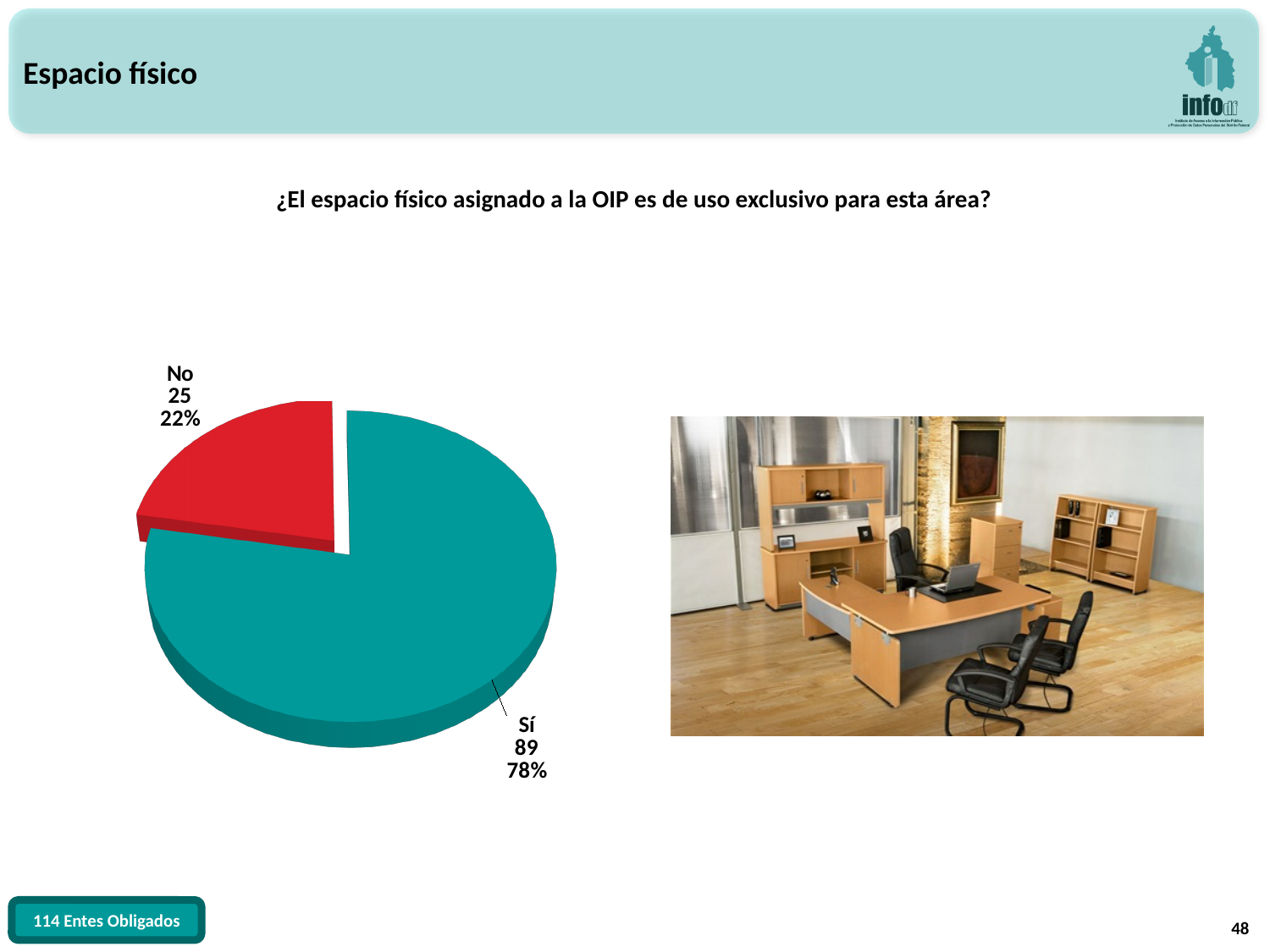
Which slice is the smallest? No What is the count for the "Sí" slice? 89 What is the total of the two slice counts? 114 How many slices does the pie chart have? 2 What colour is the "No" slice? red Which is larger, the "Sí" slice or the "No" slice? Sí What is the difference between the counts for "Sí" and "No"? 64 What percentage share does the "Sí" slice represent? 78% What kind of chart is shown on the slide? pie chart What percentage share does the "No" slice represent? 22% What is the count for the "No" slice? 25 Which slice is the largest? Sí